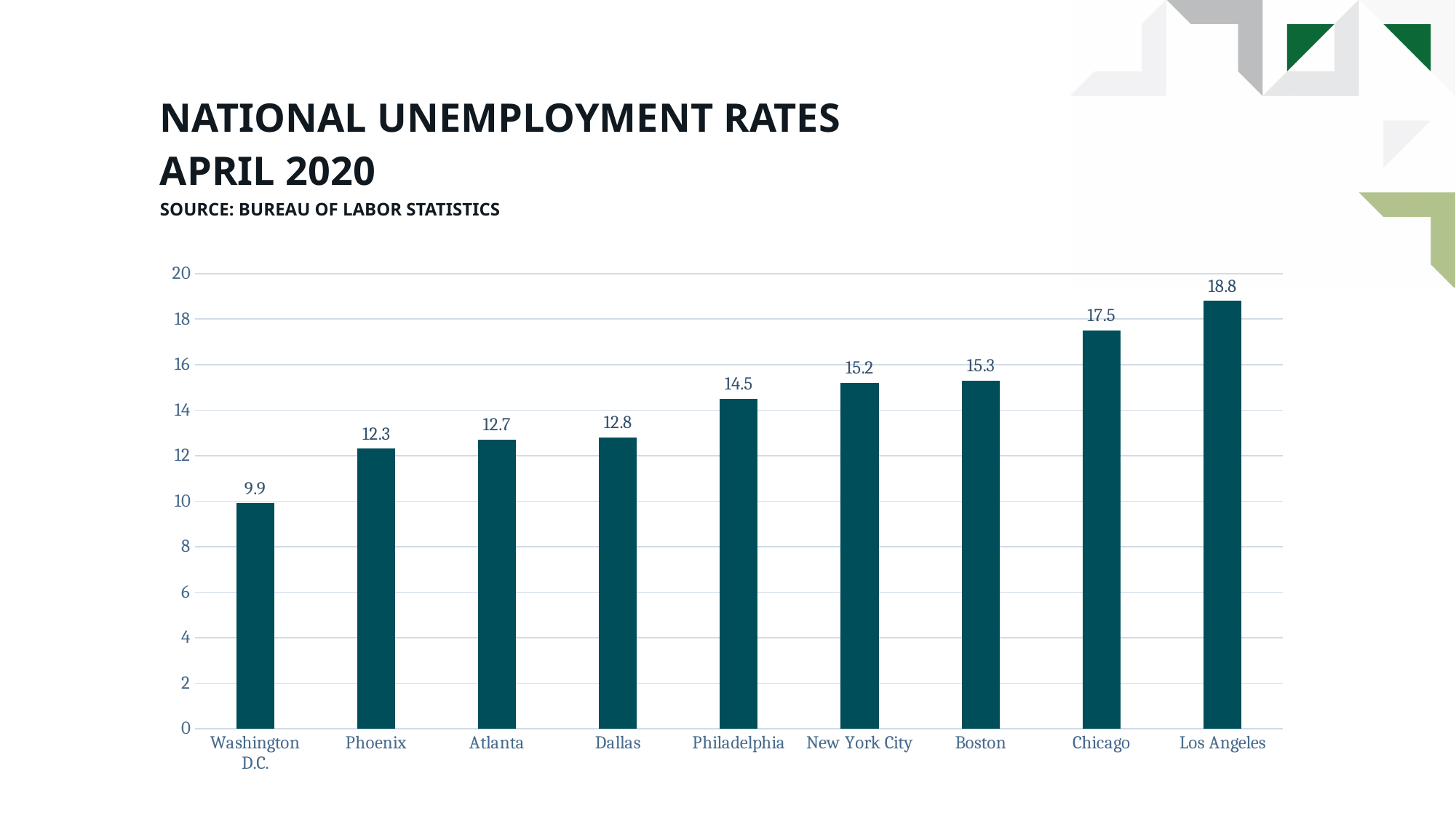
What is the unemployment rate shown for Philadelphia? 14.5 What is the difference between the unemployment rates of Los Angeles and Washington D.C.? 8.9 Which has a higher unemployment rate, Phoenix or Atlanta? Atlanta What is the unemployment rate shown for Chicago? 17.5 How many cities are shown on the chart? 9 Which city has the lowest unemployment rate on the chart? Washington D.C. Which city has the highest unemployment rate on the chart? Los Angeles What kind of chart is shown on the slide? Bar chart What is the difference between the unemployment rates of Chicago and Boston? 2.2 What is the unemployment rate shown for Washington D.C.? 9.9 What source is cited for the chart data? Bureau of Labor Statistics Is the value for New York City greater or less than 14? greater